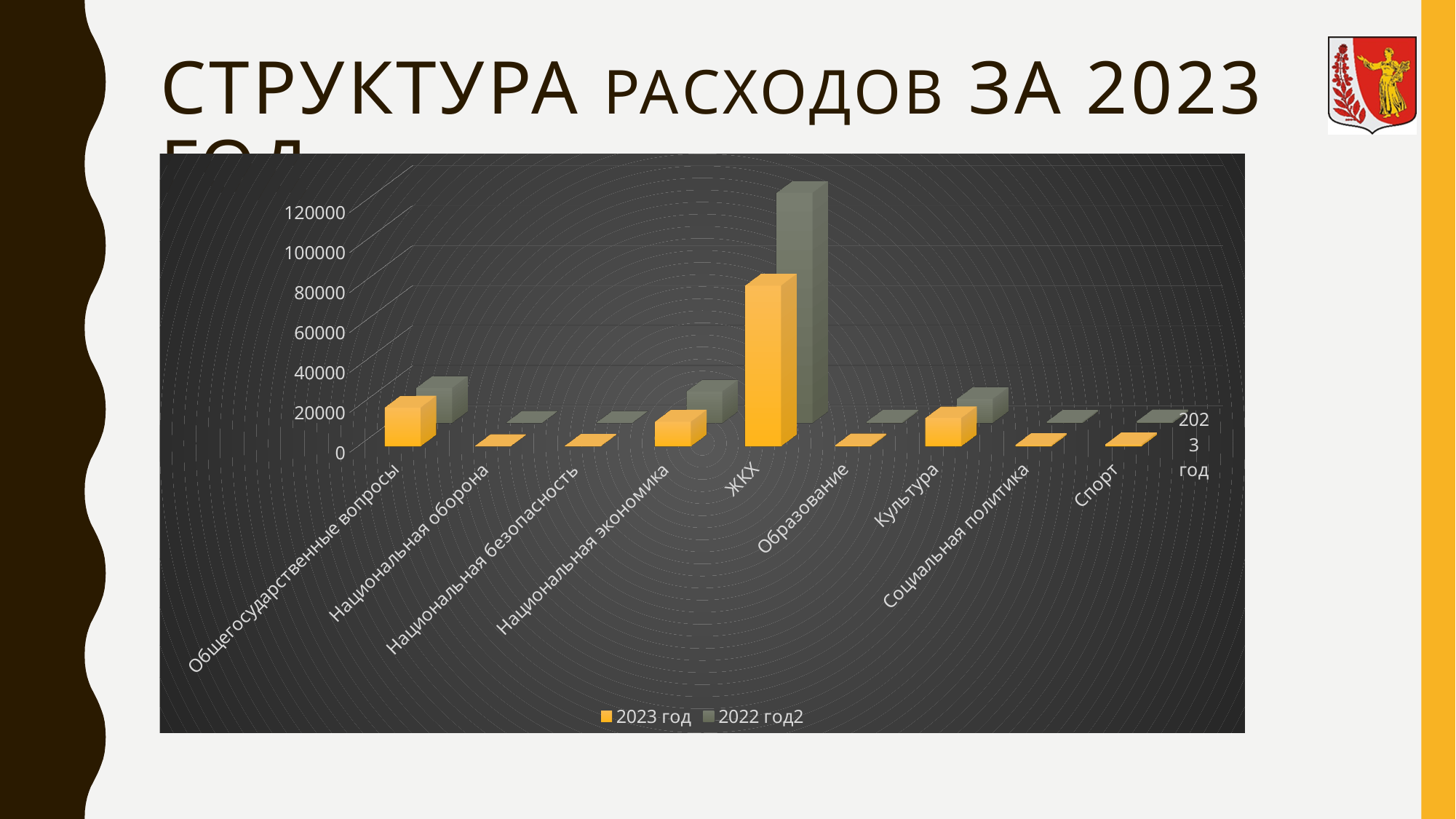
Is the 2022 год2 value for ЖКХ greater or less than 80000? greater How many categories are shown on the x axis? 9 Which is larger in the 2023 год series: ЖКХ or Культура? ЖКХ What are the two legend entries of the chart? 2023 год and 2022 год2 For ЖКХ, which series has the larger value, 2023 год or 2022 год2? 2022 год2 How many series does the legend list? 2 What kind of chart is shown on the slide? bar chart Is the 2023 год value for ЖКХ greater or less than 40000? greater Which category has the highest value for the 2022 год2 series? ЖКХ Is the 2023 год value for Национальная экономика greater or less than 40000? less Which category has the highest value for the 2023 год series? ЖКХ